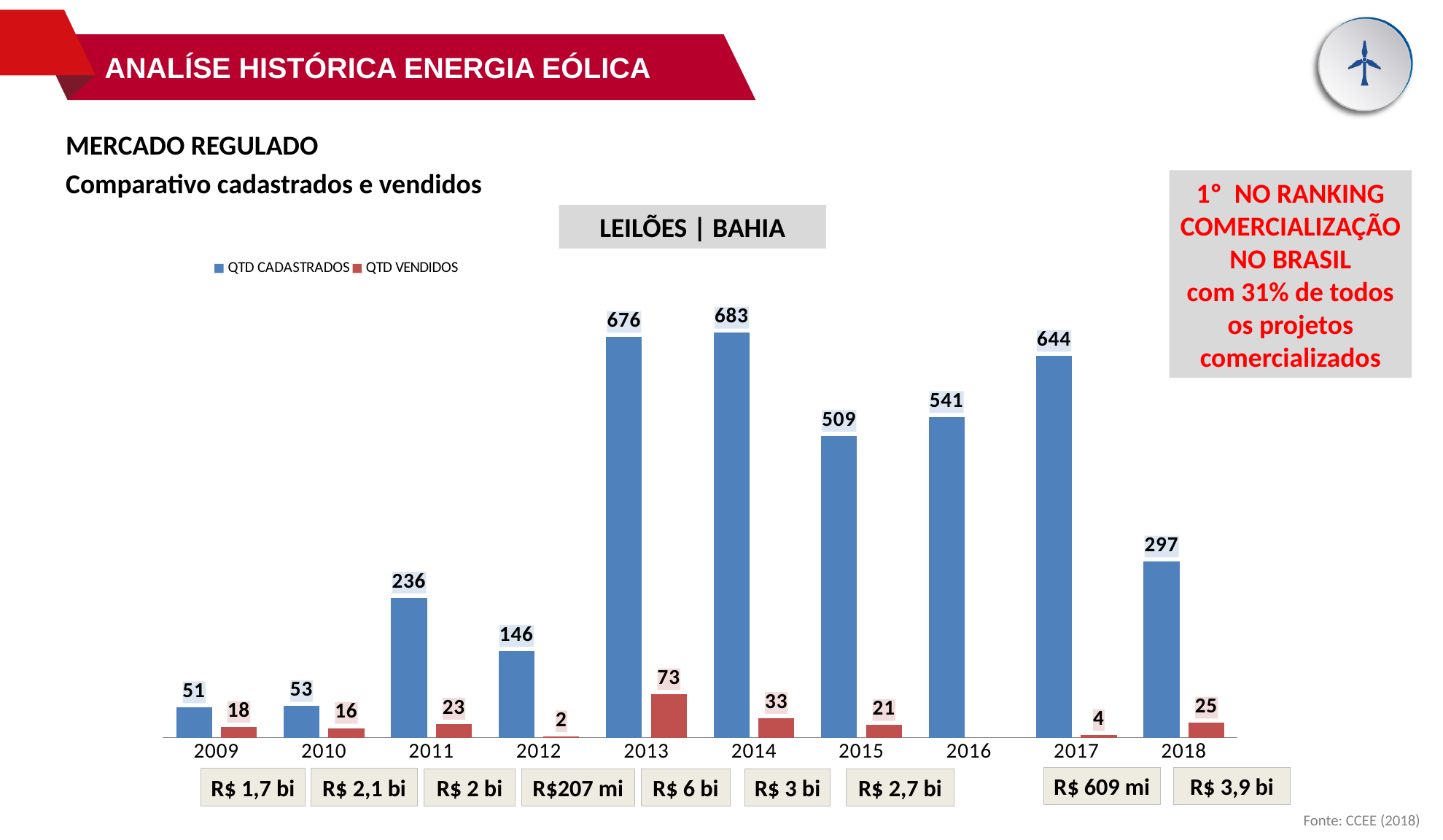
How many series does the legend list? 2 What is the QTD CADASTRADOS value for 2014? 683 What kind of chart is shown on the slide? Bar chart What is the difference between QTD CADASTRADOS and QTD VENDIDOS in 2014? 650 Which year has the highest QTD CADASTRADOS value? 2014 What is the QTD CADASTRADOS value for 2018? 297 Does the QTD CADASTRADOS value rise or fall from 2014 to 2015? Fall How many years are shown on the x axis of the chart? 10 Which is larger, the QTD CADASTRADOS value for 2016 or for 2017? 2017 Which year has the lowest QTD CADASTRADOS value? 2009 What is the QTD VENDIDOS value for 2013? 73 Which year has the highest QTD VENDIDOS value? 2013